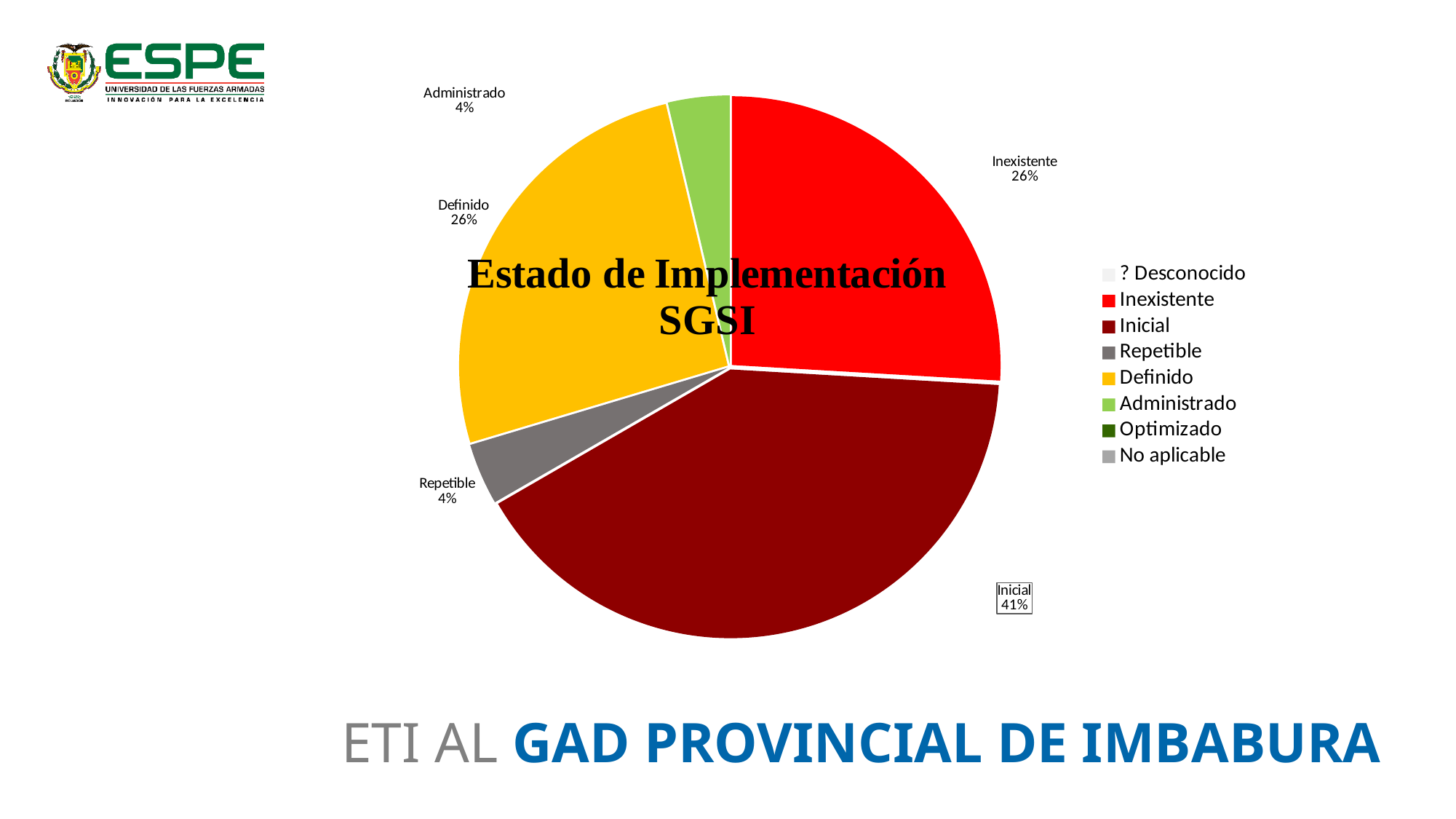
What share of the pie does Inicial represent? 41% What is the title of the chart? Estado de Implementación SGSI What share of the pie does Administrado represent? 4% What is the difference in percentage points between Inicial and Definido? 15 Which is larger, the slice for Inicial or the slice for Inexistente? Inicial Which category has the largest slice of the pie? Inicial What share of the pie does Definido represent? 26% How many entries does the legend list? 8 How many slices with data labels are shown in the pie? 5 What kind of chart is shown on the slide? pie chart